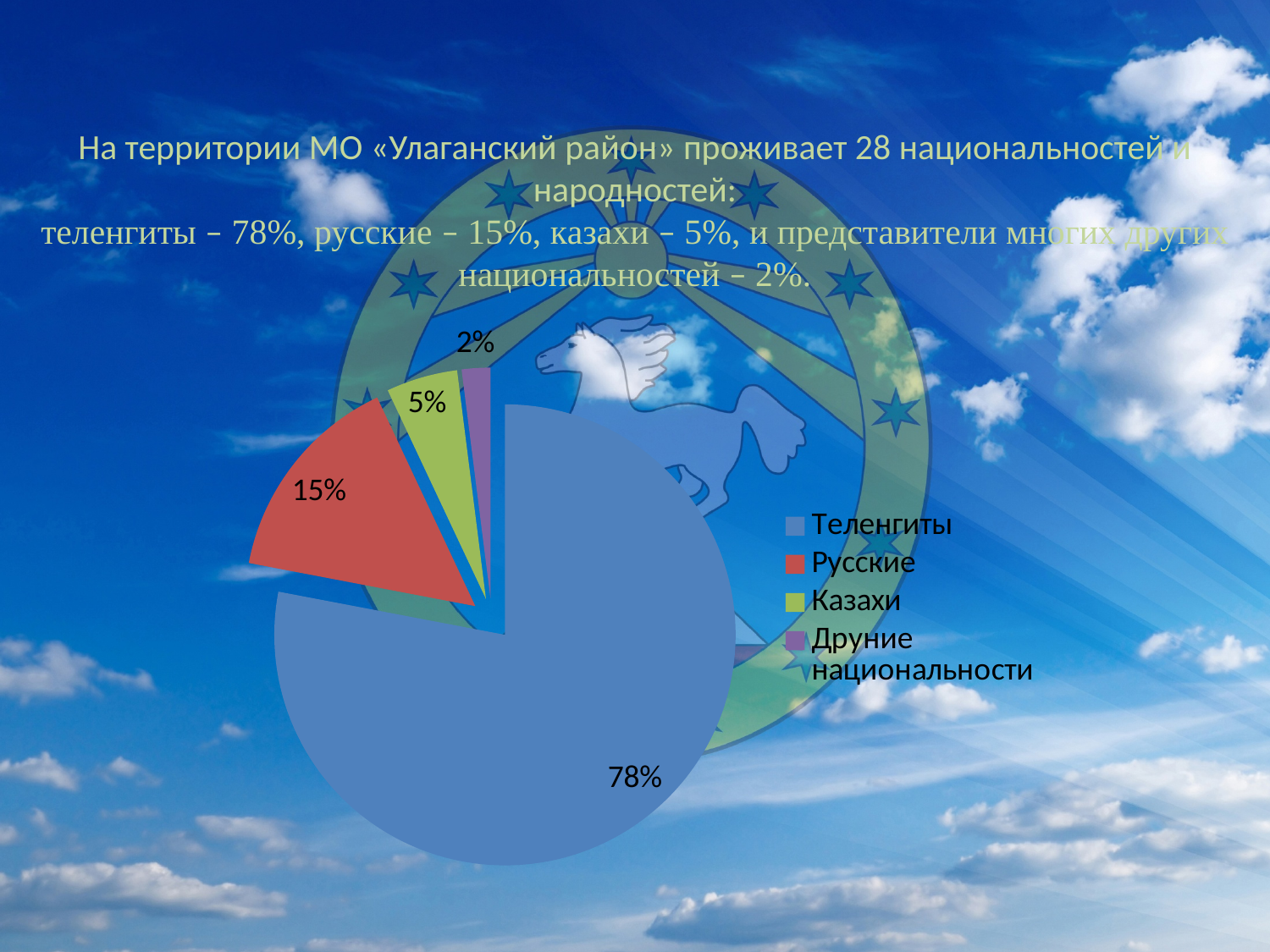
What share of the pie does Теленгиты have? 78% What is the difference between the shares of Казахи and Другие национальности? 3% How many categories does the legend list? 4 What colour is the slice for Русские? red What kind of chart is shown on the slide? pie chart Which category has the smallest slice of the pie? Друние национальности What share of the pie does Другие национальности have? 2% Which category has the largest slice of the pie? Теленгиты Which is larger, the share of Русские or the share of Казахи? Русские What share of the pie does Казахи have? 5% What is the difference between the shares of Теленгиты and Русские? 63%